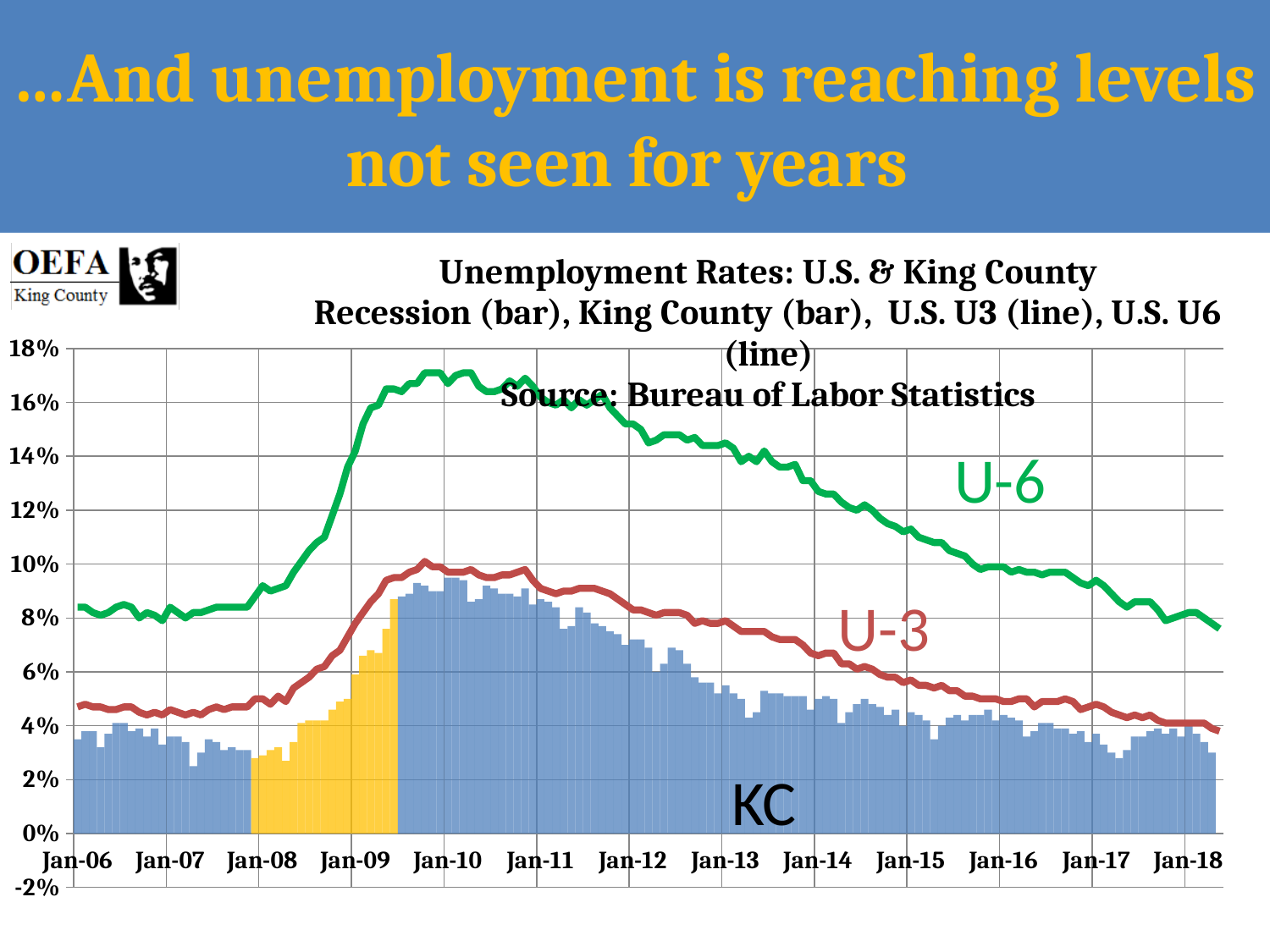
Is the U-6 line at Jan-06 greater or less than 10%? less What is the title of the chart? Unemployment Rates: U.S. & King County What is the source of the data cited on the chart? Bureau of Labor Statistics What kind of chart is shown on the slide? A combination chart with bars and lines At Jan-10, which is larger, the U-6 line or the U-3 line? U-6 Does the U-6 line rise or fall from Jan-10 to Jan-18? fall Is the peak of the U-6 line around Jan-10 greater or less than 16%? greater Is the U-3 line at Jan-18 greater or less than 6%? less How many data series does the chart's subtitle list? 4 Does the U-3 line rise or fall from Jan-08 to Jan-10? rise How many year labels are shown on the x axis? 13